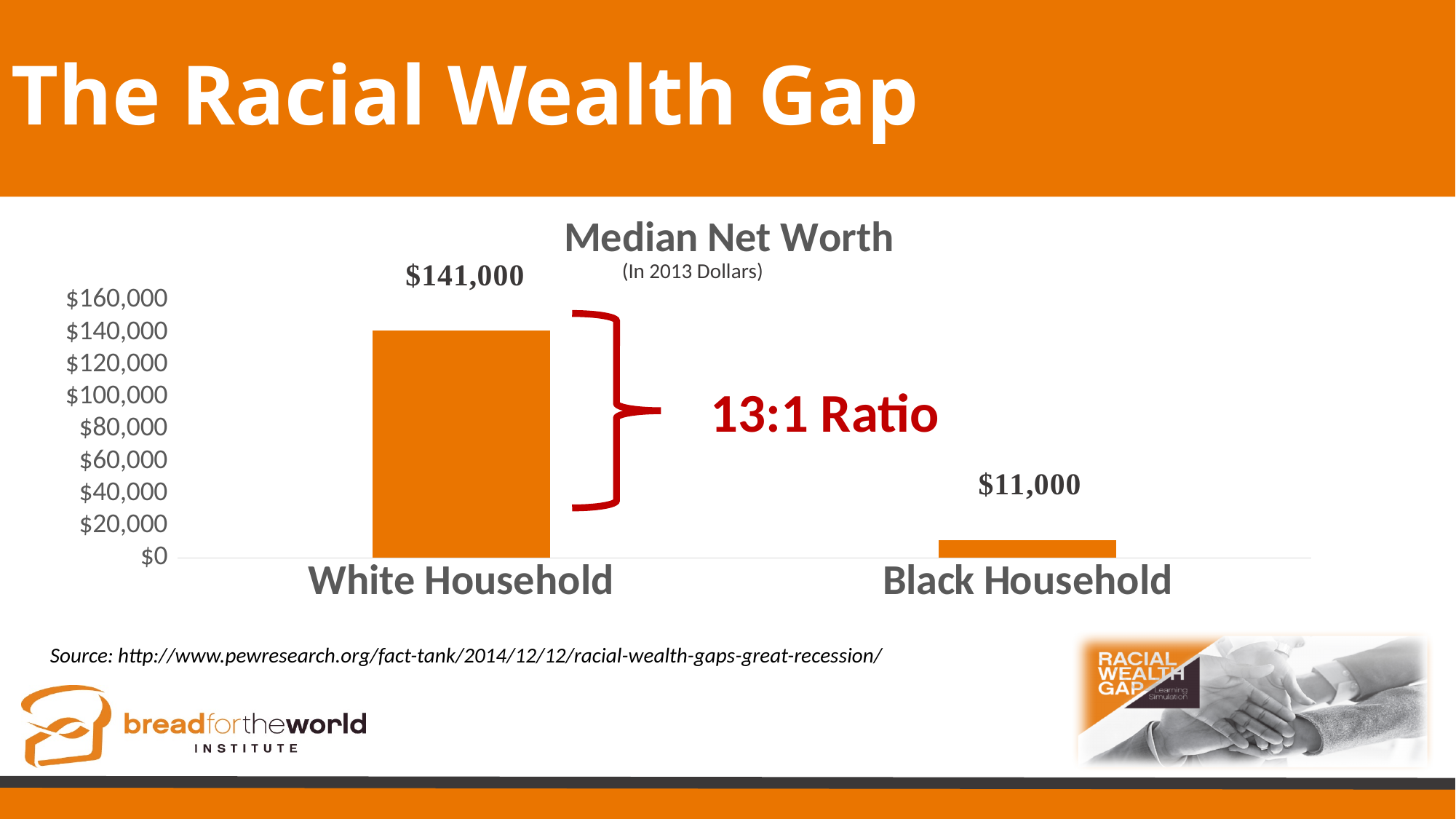
Which category has the lowest median net worth? Black Household How many categories are shown in the chart? 2 What is the median net worth for Black Household? $11,000 What ratio is annotated in red on the chart? 13:1 Ratio Which is larger, the median net worth for White Household or for Black Household? White Household Which category has the highest median net worth? White Household What is the title of the chart? Median Net Worth Is the value for Black Household greater or less than $20,000? less What kind of chart is shown on the slide? bar chart What is the median net worth for White Household? $141,000 Is the value for White Household greater or less than $120,000? greater What is the difference in median net worth between White Household and Black Household? $130,000